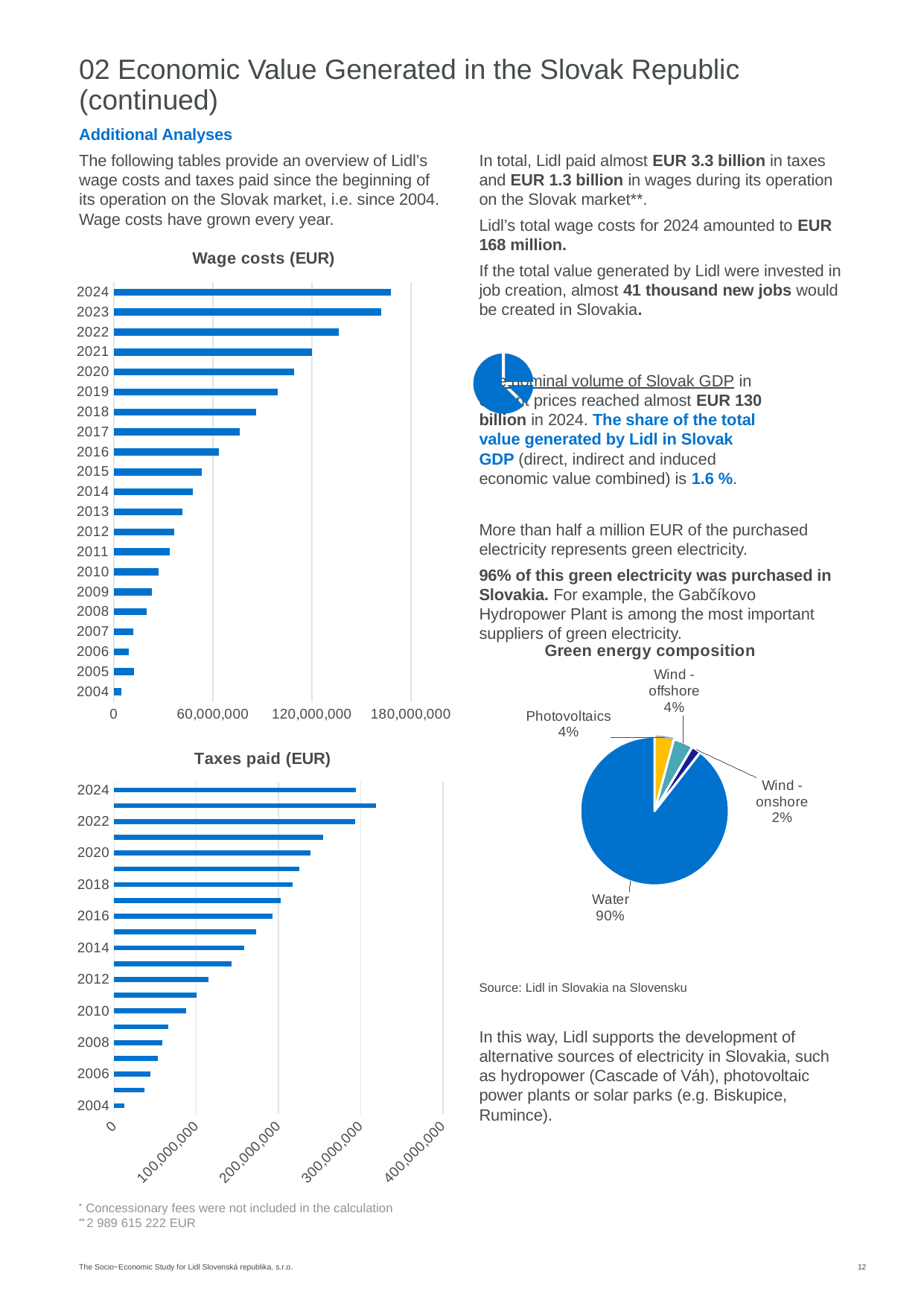
In the 'Wage costs (EUR)' chart, do wage costs rise or fall from 2004 to 2024? rise What kind of chart is the 'Wage costs (EUR)' chart? bar chart In the 'Wage costs (EUR)' chart, which year has the lowest wage costs? 2004 In the 'Taxes paid (EUR)' chart, is the value for 2008 greater or less than 100,000,000? less In the 'Wage costs (EUR)' chart, which year has the highest wage costs? 2024 How many years are shown in the 'Wage costs (EUR)' chart? 21 In the 'Green energy composition' pie chart, what is the difference between the Water share and the Photovoltaics share? 86% In the 'Taxes paid (EUR)' chart, which year has the lowest taxes paid? 2004 In the 'Green energy composition' pie chart, what share does Water have? 90% In the 'Green energy composition' pie chart, which source has the smallest share? Wind - onshore In the 'Taxes paid (EUR)' chart, is the value for 2024 greater or less than 200,000,000? greater In the 'Wage costs (EUR)' chart, is the value for 2024 greater or less than 120,000,000? greater